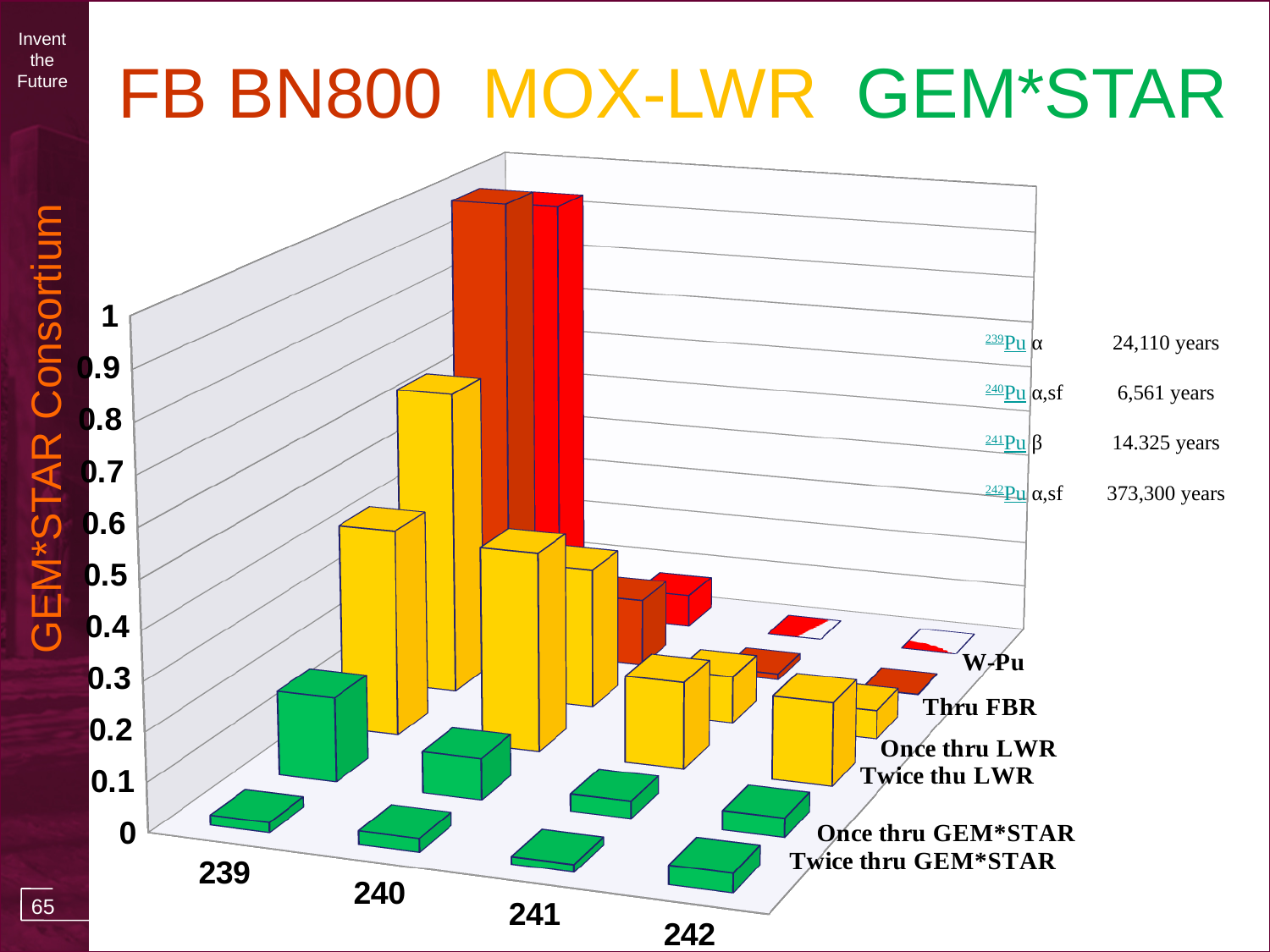
For isotope 239, which is taller: the W-Pu bar or the Once thru GEM*STAR bar? W-Pu Which isotope has the tallest W-Pu bar? 239 For the W-Pu series, do the bars rise or fall from isotope 239 to 242? fall Is the Once thru GEM*STAR bar for isotope 239 greater or less than 0.5? less Is the Twice thru GEM*STAR bar for isotope 239 greater or less than 0.1? less In the slide title, what colour is the text 'GEM*STAR'? green What kind of chart is shown on the slide? bar chart How many fuel-cycle series are labelled along the depth axis of the chart (W-Pu through Twice thru GEM*STAR)? 6 What is the highest tick value shown on the vertical axis of the chart? 1 How many isotope categories are labelled along the x axis of the chart? 4 Which series has the smallest bar for isotope 239? Twice thru GEM*STAR